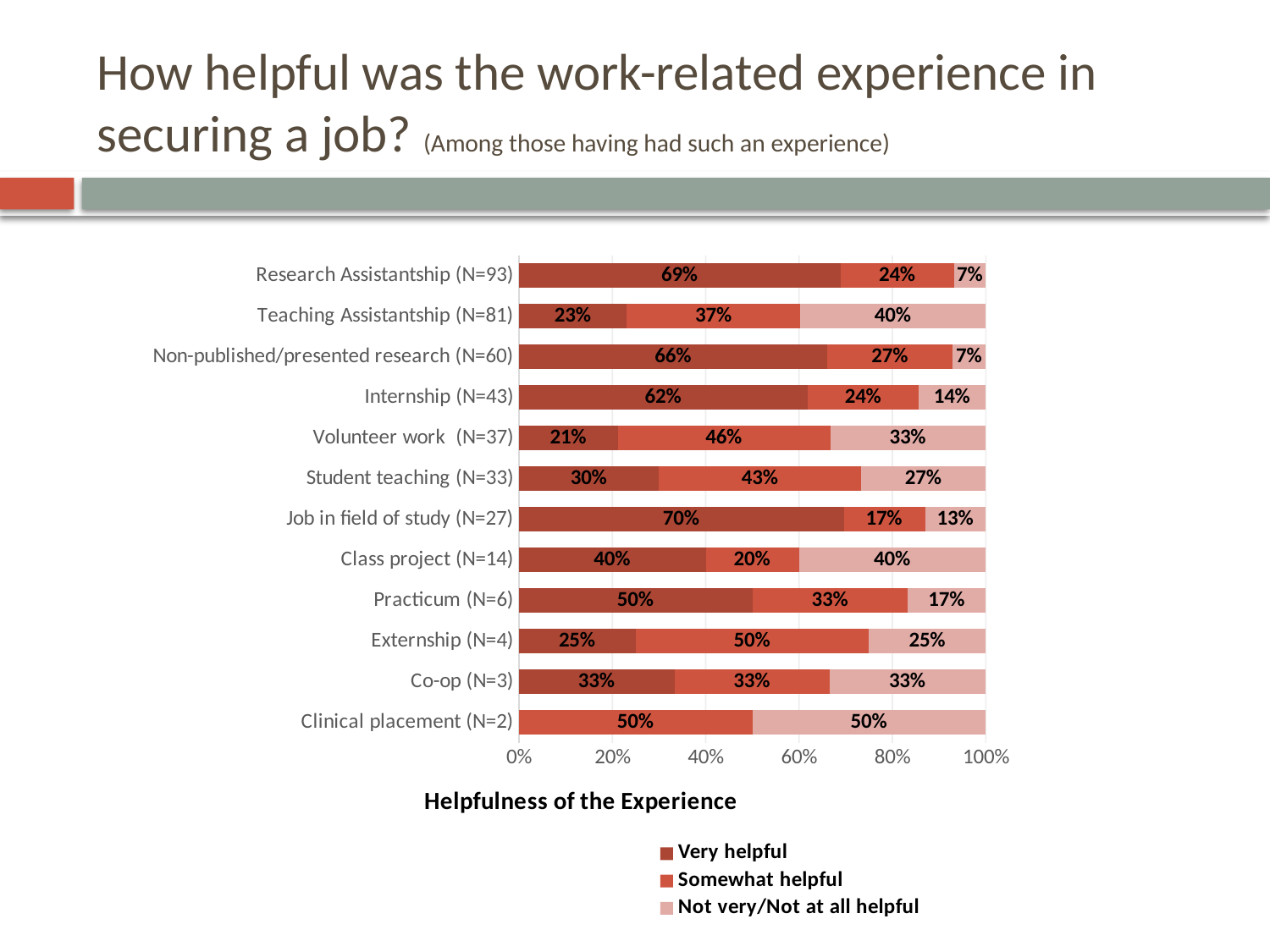
For Research Assistantship (N=93), how many percentage points higher is 'Very helpful' than 'Somewhat helpful'? 45 percentage points For Teaching Assistantship (N=81), what is the difference between the 'Not very/Not at all helpful' and 'Very helpful' values? 17 percentage points What type of chart is shown on the slide? Stacked bar chart What is the 'Very helpful' value for Job in field of study (N=27)? 70% Which is larger: the 'Very helpful' value for Internship (N=43) or for Non-published/presented research (N=60)? Non-published/presented research (N=60) What is the title of the chart? Helpfulness of the Experience What percentage of respondents with a Research Assistantship (N=93) found it very helpful? 69% What percentage of respondents with a Teaching Assistantship (N=81) found it not very/not at all helpful? 40% How many series does the legend list? 3 What is the 'Somewhat helpful' value for Volunteer work (N=37)? 46% Which experience has the highest 'Somewhat helpful' percentage? Externship (N=4) and Clinical placement (N=2), tied at 50% How many work-related experience categories are shown on the chart? 12